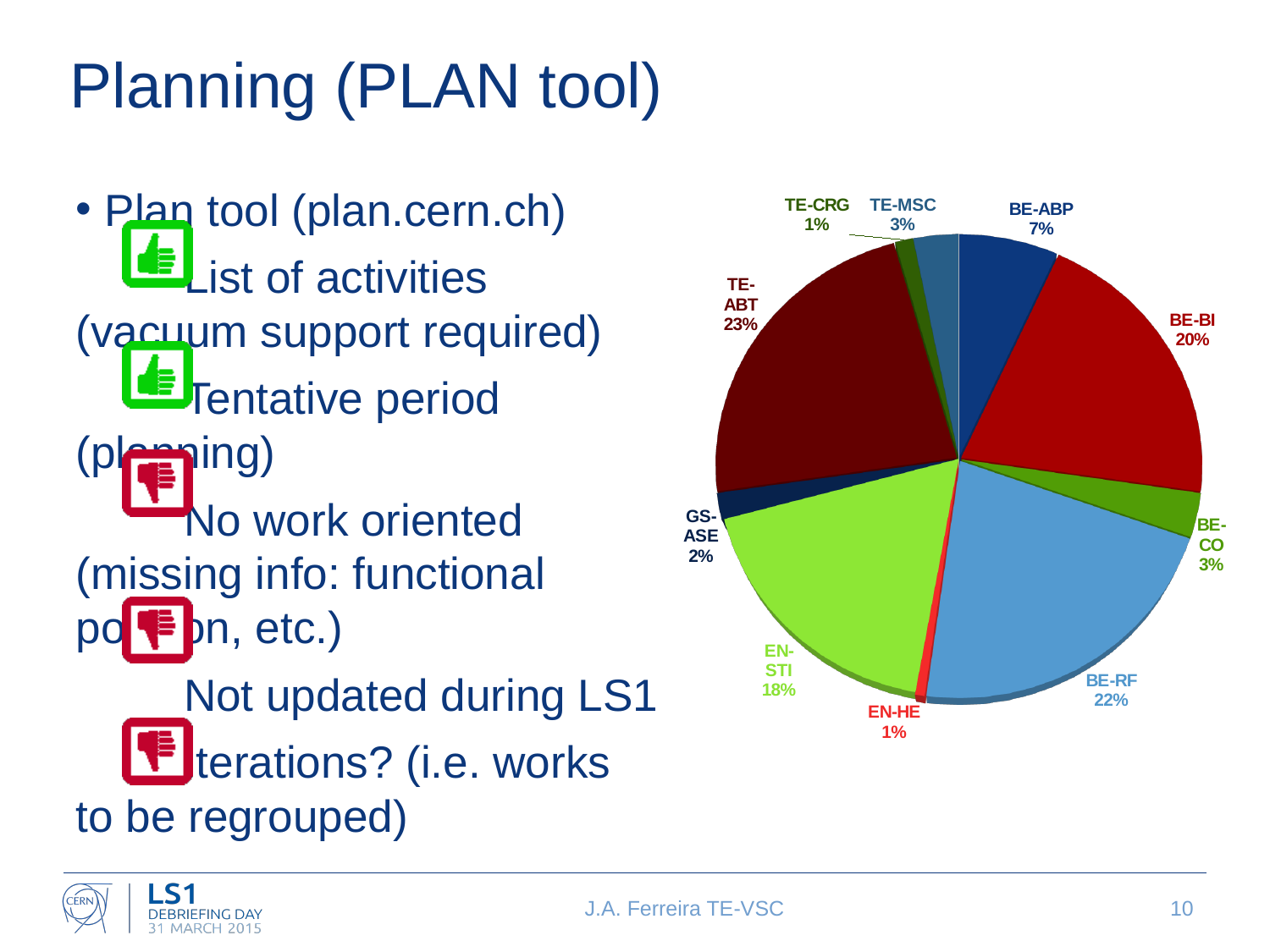
What is the combined share of TE-MSC and BE-CO? 6% What is the difference between the shares of BE-BI and EN-STI? 2% What percentage is shown for BE-ABP? 7% Which has a larger share, BE-BI or BE-ABP? BE-BI What percentage is shown for EN-STI? 18% Which slice is labelled with 1% next to BE-RF at the bottom of the pie? EN-HE What share of the pie does TE-ABT have? 23% What share of the pie does BE-RF have? 22% Which slice has the largest share of the pie? TE-ABT What percentage is shown for GS-ASE? 2% What kind of chart is shown on the slide? Pie chart How many slices does the pie chart have? 10